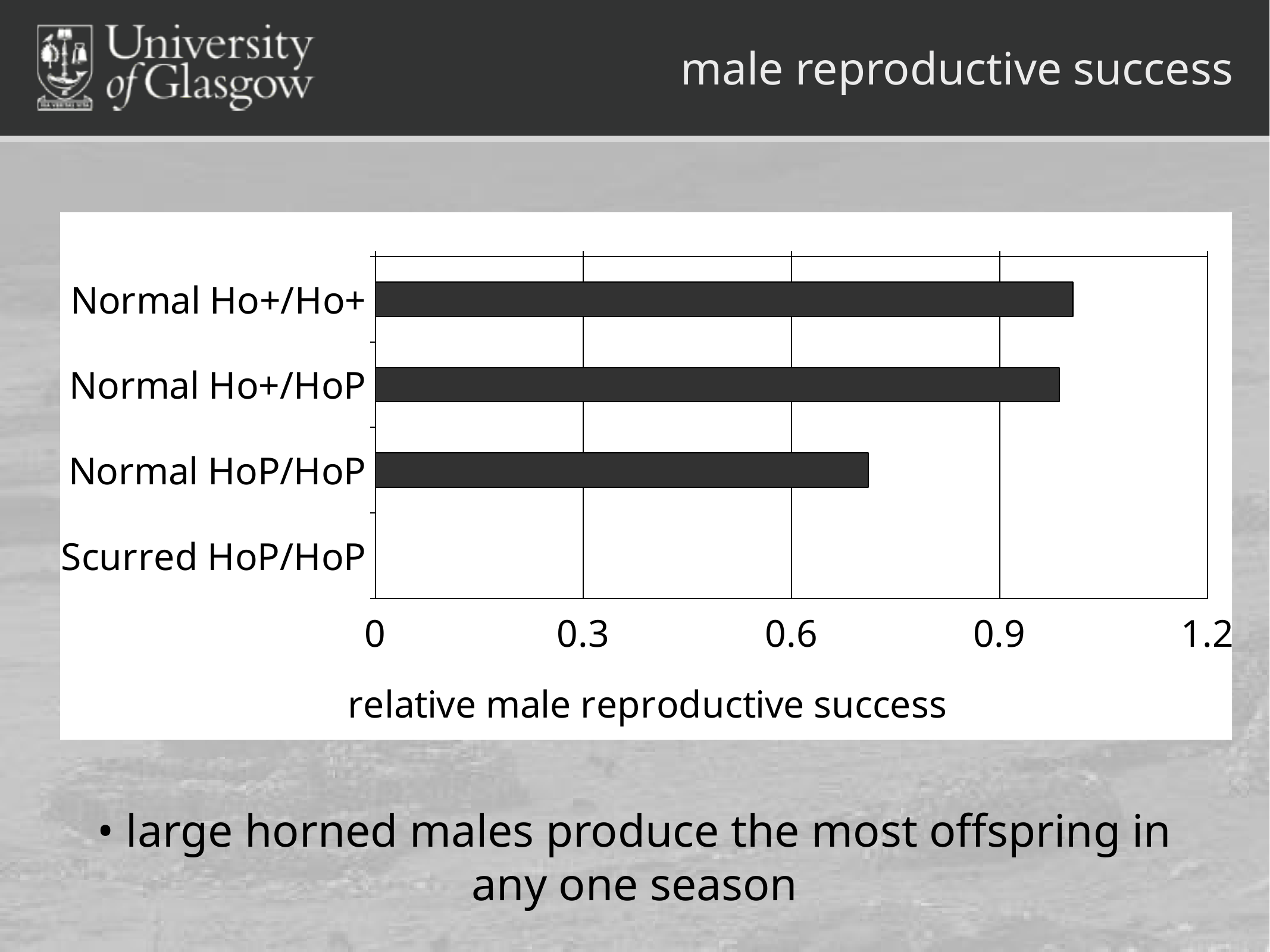
Which has the larger relative male reproductive success, Normal Ho+/HoP or Normal HoP/HoP? Normal Ho+/HoP Which category has the lowest relative male reproductive success? Scurred HoP/HoP Is the value for Normal HoP/HoP greater or less than 0.9? less How many categories are plotted in the chart? 4 What is the label of the horizontal axis of the chart? relative male reproductive success Is the value for Normal Ho+/Ho+ greater or less than 0.9? greater Is the value for Normal Ho+/Ho+ greater or less than 1.2? less What kind of chart is shown on the slide? bar chart What is the title shown at the top of the slide? male reproductive success Which has the larger relative male reproductive success, Normal HoP/HoP or Scurred HoP/HoP? Normal HoP/HoP